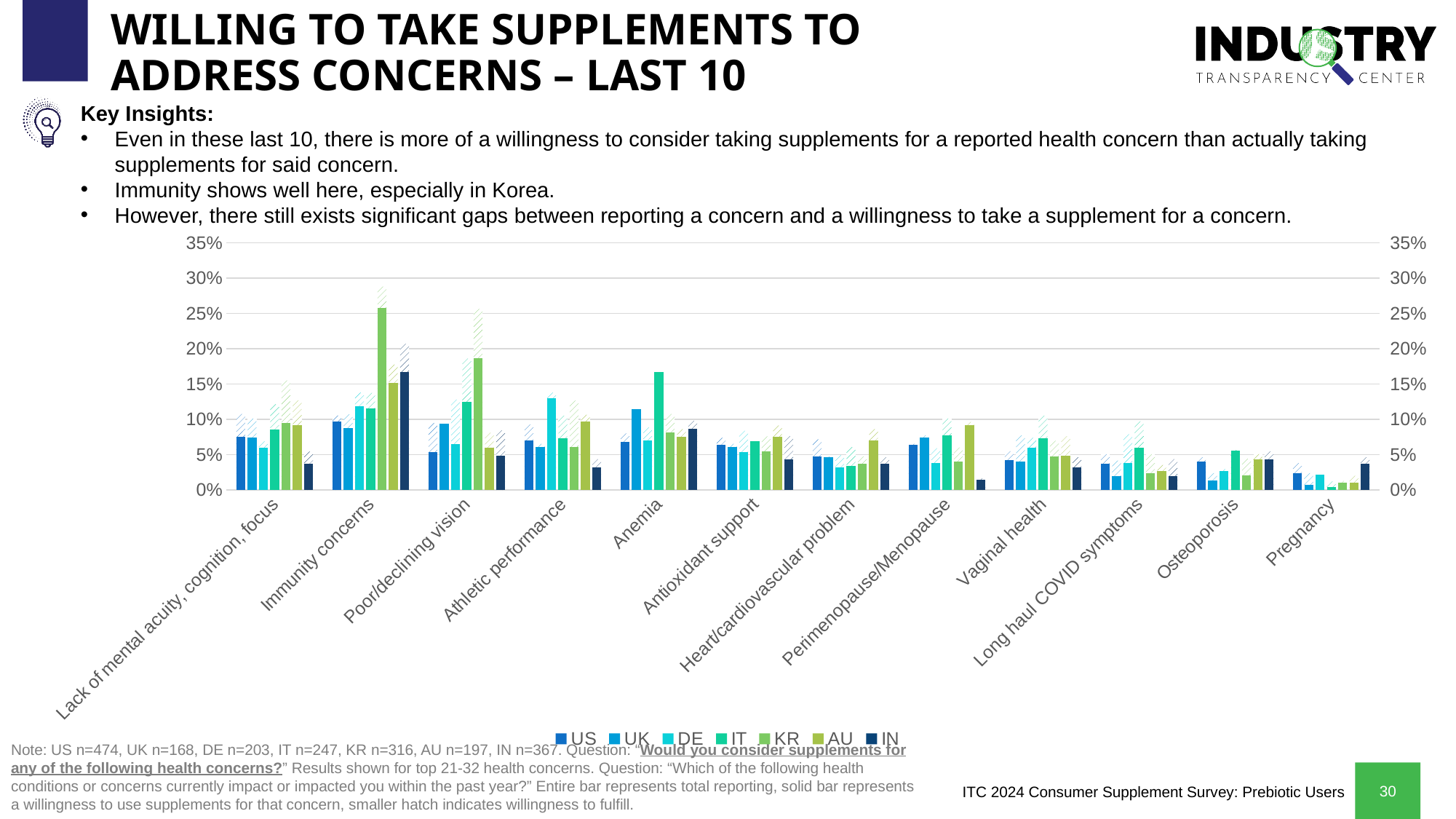
Which country has the tallest solid bar for Anemia? IT How many health concern categories are shown on the x axis of the chart? 12 How many series does the chart legend list? 7 Is the solid bar value for IN under Perimenopause/Menopause greater or less than 5%? less Which country has the tallest solid bar for Immunity concerns? KR Which series is listed last in the chart legend? IN For Immunity concerns, which solid bar is larger: KR or US? KR Is the solid bar value for IT under Anemia greater or less than 10%? greater Is the solid bar value for KR under Immunity concerns greater or less than 20%? greater Which country has the tallest solid bar for Poor/declining vision? KR What kind of chart is shown on the slide? bar chart